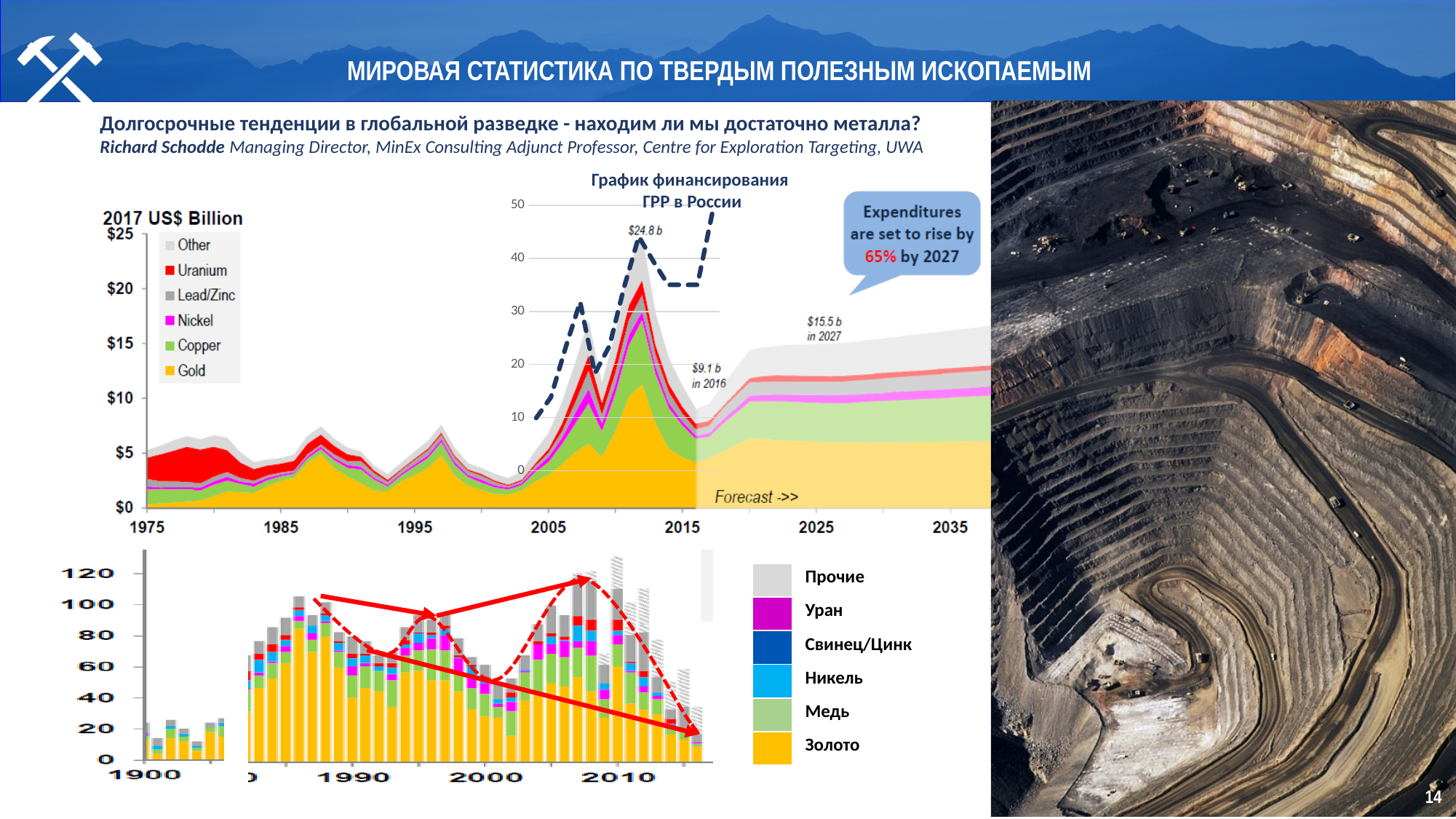
In the top chart, what is the labelled forecast expenditure value in 2027? $15.5 b In the top chart, do the values rise or fall between 2012 and 2016? Fall In the top chart, what is the labelled expenditure value in 2016? $9.1 b In the top chart, which is larger: the 2016 value or the 2027 forecast value? 2027 forecast value What kind of chart is the bottom chart with the Russian legend (Прочие, Уран, Золото)? Stacked bar chart In the top chart, what is the difference between the 2027 forecast value and the 2016 value? $6.4 b In the top chart, what is the labelled peak value of exploration expenditure around 2012? $24.8 b How many series does the legend of the top chart list? 6 What kind of chart is the top chart labelled '2017 US$ Billion'? Stacked area chart In the bottom chart, is the value of the first bar around 1900 greater or less than 40? less According to the callout on the top chart, by what percentage are expenditures set to rise by 2027? 65% In the top chart, which commodity accounts for the largest share of expenditure at the peak around 2012? Gold